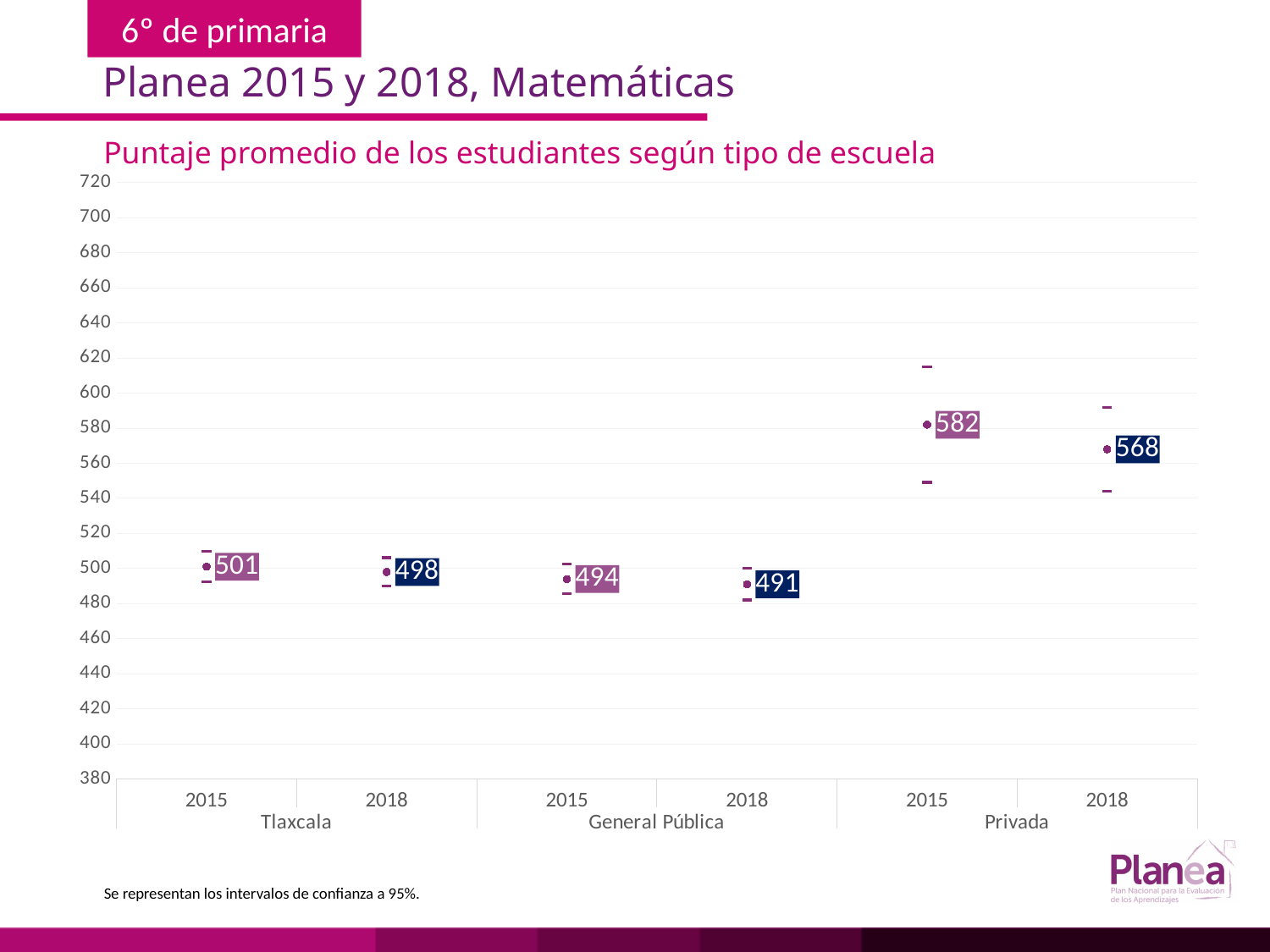
What is the average score for General Pública in 2018? 491 What is the average score for Tlaxcala in 2018? 498 Which school type and year has the highest average score? Privada 2015 Which school type and year has the lowest average score? General Pública 2018 How many data points are plotted on the chart? 6 What is the average score for Tlaxcala in 2015? 501 Which is larger, the Tlaxcala 2015 score or the General Pública 2015 score? Tlaxcala 2015 What is the difference between the Privada scores in 2015 and 2018? 14 What is the title of the chart? Puntaje promedio de los estudiantes según tipo de escuela What is the average score for General Pública in 2015? 494 What is the average score for Privada in 2018? 568 What is the average score for Privada in 2015? 582